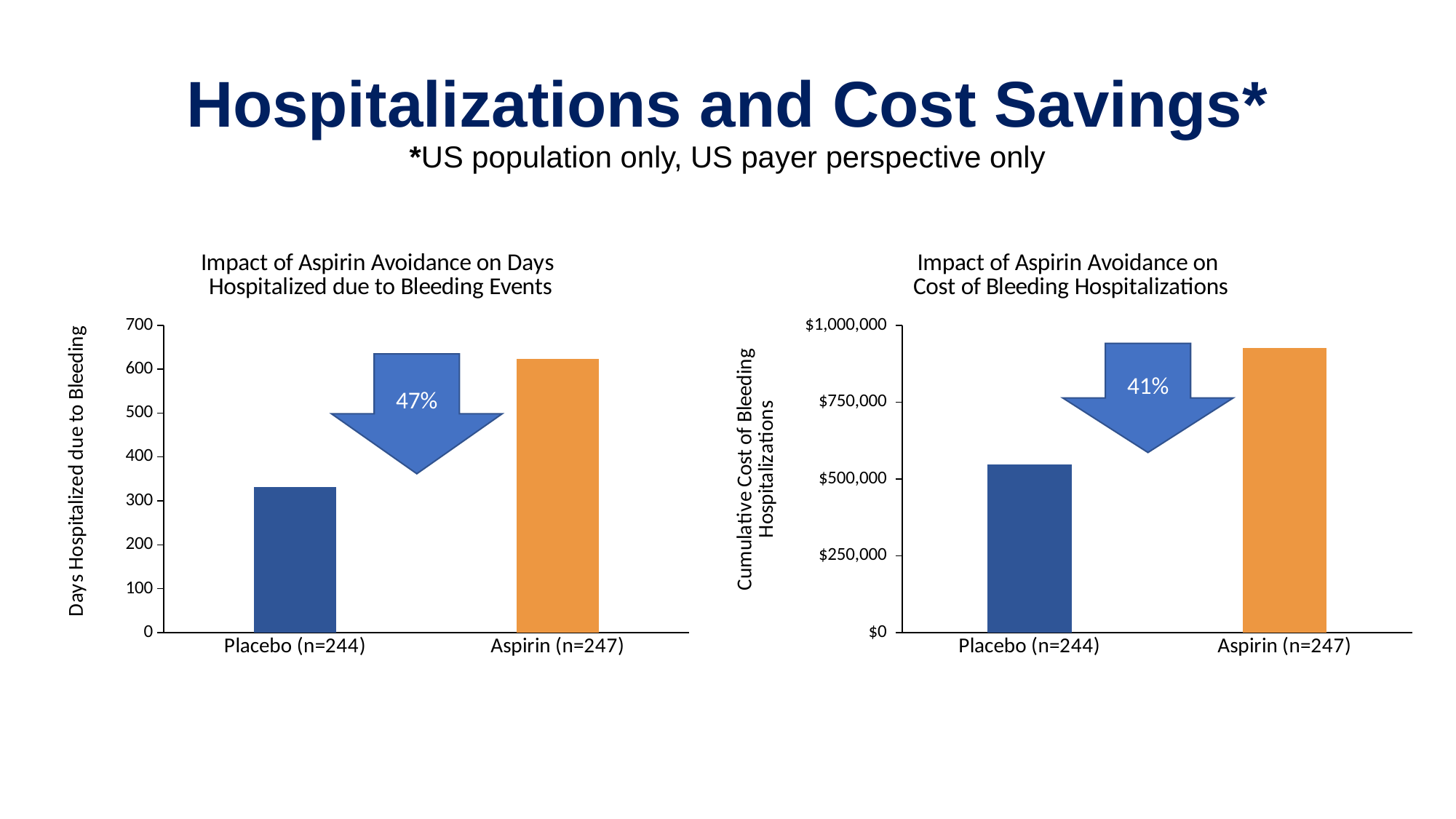
In the left chart, is the value for Aspirin (n=247) greater or less than 600? greater In the right chart, is the value for Aspirin (n=247) greater or less than $750,000? greater In the chart titled 'Impact of Aspirin Avoidance on Cost of Bleeding Hospitalizations', which category has the higher bar? Aspirin (n=247) What percentage reduction is shown by the arrow in the left chart? 47% In the chart titled 'Impact of Aspirin Avoidance on Days Hospitalized due to Bleeding Events', which category has the lower bar? Placebo (n=244) In the chart titled 'Impact of Aspirin Avoidance on Days Hospitalized due to Bleeding Events', which category has the higher bar? Aspirin (n=247) What percentage reduction is shown by the arrow in the right chart? 41% How many categories are shown on the x axis of the left chart? 2 What kind of chart is the chart titled 'Impact of Aspirin Avoidance on Cost of Bleeding Hospitalizations'? bar chart In the right chart, is the bar for Placebo (n=244) larger or smaller than the bar for Aspirin (n=247)? smaller In the left chart, is the value for Placebo (n=244) greater or less than 400? less